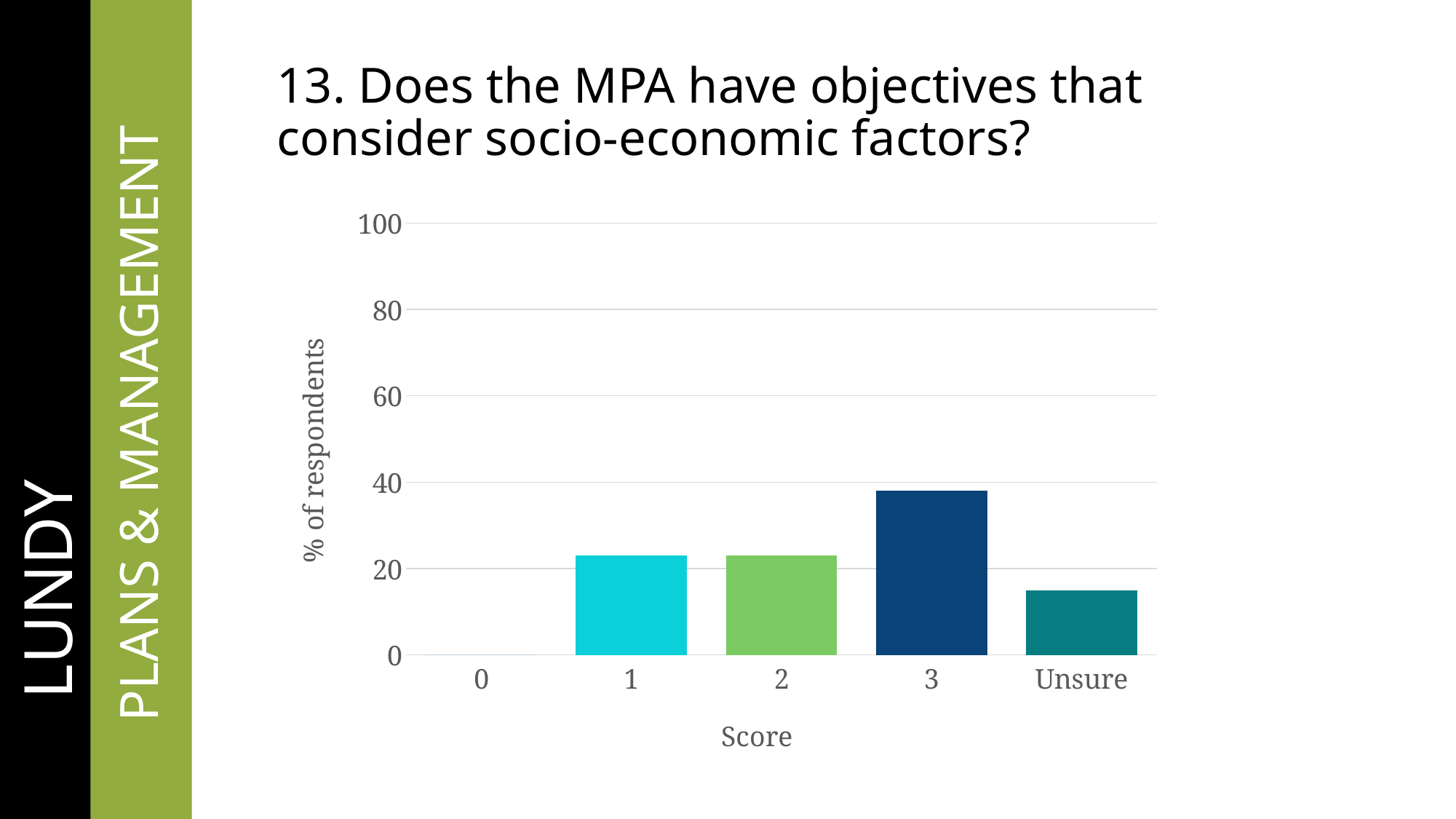
Is the value for score 2 greater or less than 40? less Is the value for score 1 greater or less than 20? greater Which score category has the highest percentage of respondents? 3 What kind of chart is shown on the slide? bar chart Which score category has the lowest percentage of respondents? 0 What is the label of the x axis? Score Is the value for score 3 greater or less than 40? less What is the label of the y axis? % of respondents Which is larger, the value for score 3 or the value for Unsure? 3 How many score categories are shown on the x axis? 5